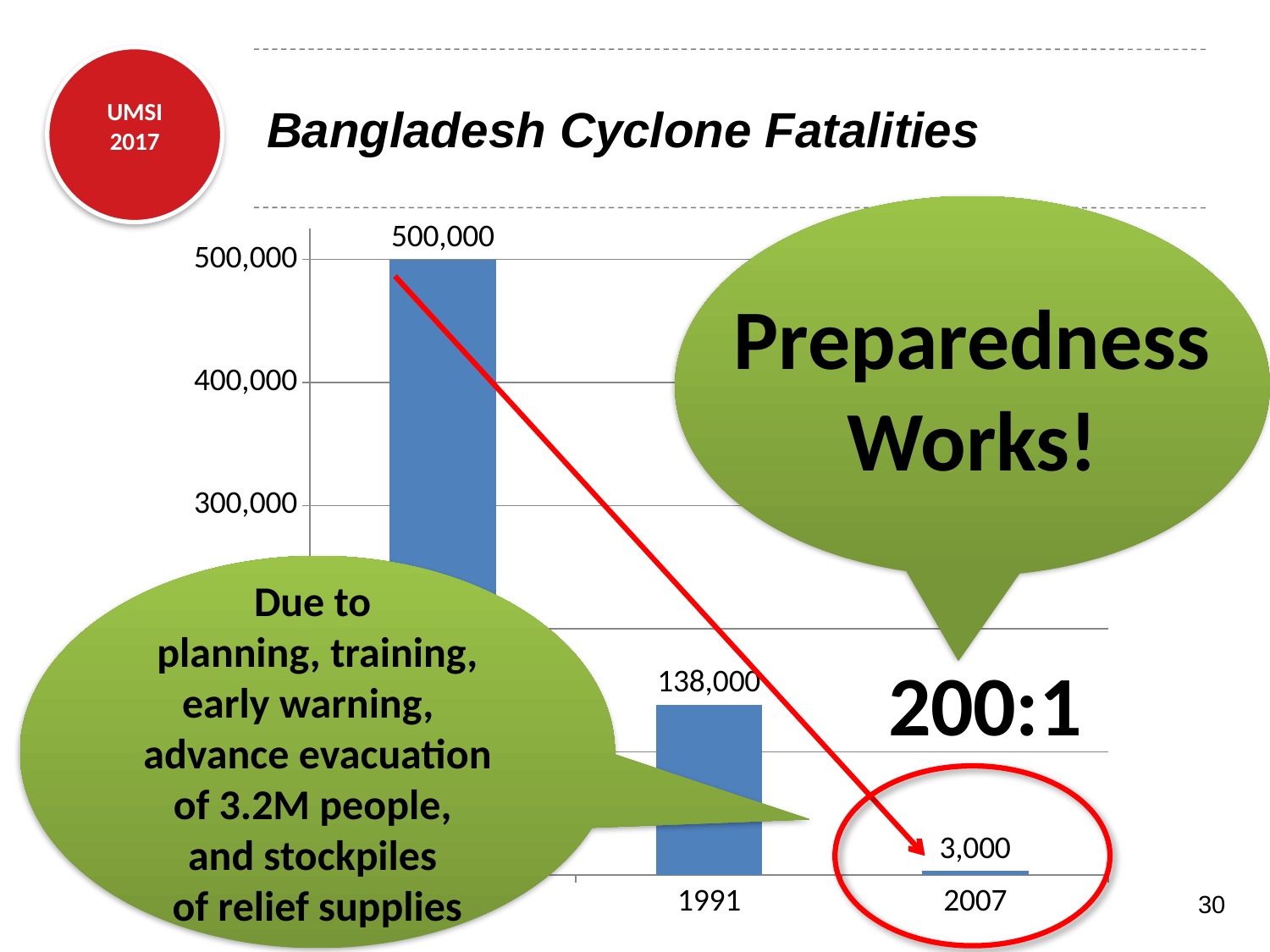
Is the value for 1991 greater or less than 200,000? less What is the title of the chart? Bangladesh Cyclone Fatalities Which year has the lowest fatalities in the chart? 2007 What kind of chart is shown on the slide? bar chart How many bars are plotted in the chart? 3 Is the value for 2007 greater or less than 100,000? less What is the difference between the 1991 and 2007 values? 135,000 Which is larger, the value for 1991 or the value for 2007? 1991 What is the value for 1991 in the Bangladesh Cyclone Fatalities chart? 138,000 What is the highest value shown on the y axis? 500,000 What is the value for 2007 in the Bangladesh Cyclone Fatalities chart? 3,000 Do the values rise or fall from left to right along the x axis? fall